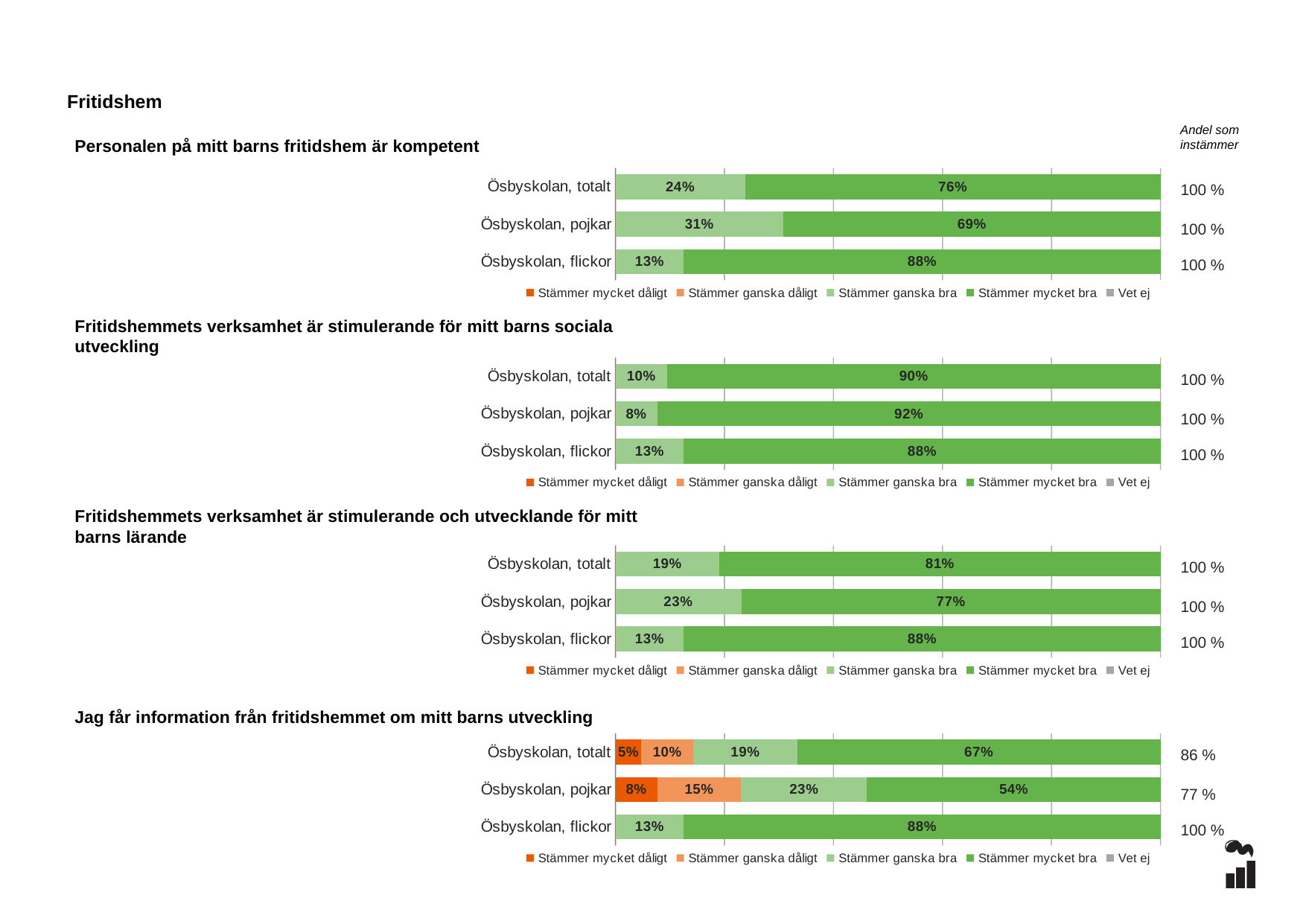
In the chart 'Fritidshemmets verksamhet är stimulerande för mitt barns sociala utveckling', which category has the lowest 'Stämmer ganska bra' value? Ösbyskolan, pojkar In the chart 'Personalen på mitt barns fritidshem är kompetent', what is the 'Stämmer mycket bra' value for Ösbyskolan, pojkar? 69% How many series does the legend list for the chart 'Jag får information från fritidshemmet om mitt barns utveckling'? 5 In the chart 'Jag får information från fritidshemmet om mitt barns utveckling', what is the 'Stämmer ganska dåligt' value for Ösbyskolan, pojkar? 15% In the chart 'Jag får information från fritidshemmet om mitt barns utveckling', what is the combined share of 'Stämmer mycket dåligt' and 'Stämmer ganska dåligt' for Ösbyskolan, pojkar? 23% In the chart 'Jag får information från fritidshemmet om mitt barns utveckling', what is the 'Andel som instämmer' value for Ösbyskolan, totalt? 86 % What kind of chart is 'Personalen på mitt barns fritidshem är kompetent'? Stacked bar chart In the chart 'Fritidshemmets verksamhet är stimulerande och utvecklande för mitt barns lärande', what is the 'Stämmer ganska bra' value for Ösbyskolan, totalt? 19% In the chart 'Fritidshemmets verksamhet är stimulerande och utvecklande för mitt barns lärande', is the 'Stämmer mycket bra' value larger for Ösbyskolan, totalt or Ösbyskolan, pojkar? Ösbyskolan, totalt In the chart 'Personalen på mitt barns fritidshem är kompetent', which category has the highest 'Stämmer ganska bra' value? Ösbyskolan, pojkar In the chart 'Fritidshemmets verksamhet är stimulerande för mitt barns sociala utveckling', what is the 'Stämmer mycket bra' value for Ösbyskolan, pojkar? 92% In the chart 'Personalen på mitt barns fritidshem är kompetent', what is the difference between the 'Stämmer mycket bra' values for Ösbyskolan, flickor and Ösbyskolan, totalt? 12 percentage points